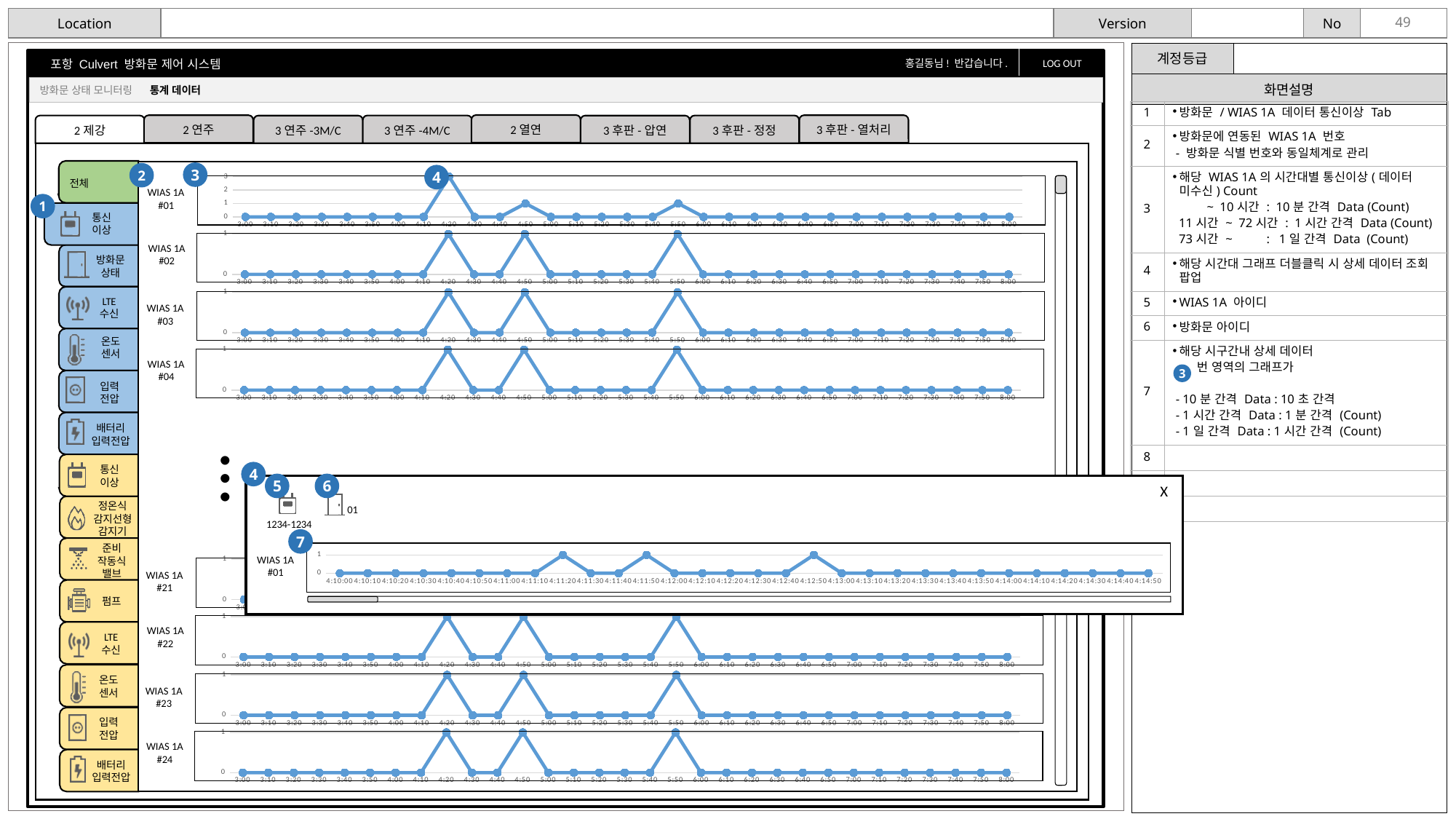
What is the highest tick value on the y axis of the WIAS 1A #01 chart in the main panel? 3 How many data points are plotted in the WIAS 1A #02 chart (from 3:00 to 8:00)? 31 In the WIAS 1A #01 chart in the main panel, what is the difference between the value at 4:20 and the value at 4:50? 2 In the WIAS 1A #01 chart in the main panel, at which time does the line reach its highest value? 4:20 In the WIAS 1A #01 chart in the main panel, what is the value at 4:20? 3 In the WIAS 1A #02 chart, what is the value at 4:20? 1 In the popup chart for WIAS 1A #01, what is the value at 4:11:20? 1 In the WIAS 1A #01 chart in the main panel, what is the value at 3:00? 0 In the WIAS 1A #02 chart, what is the value at 5:00? 0 What kind of chart is used for WIAS 1A #01 in the main panel? line chart In the popup chart for WIAS 1A #01, what is the first time label on the x axis? 4:10:00 In the WIAS 1A #01 chart in the main panel, which is larger, the value at 4:20 or the value at 4:50? 4:20